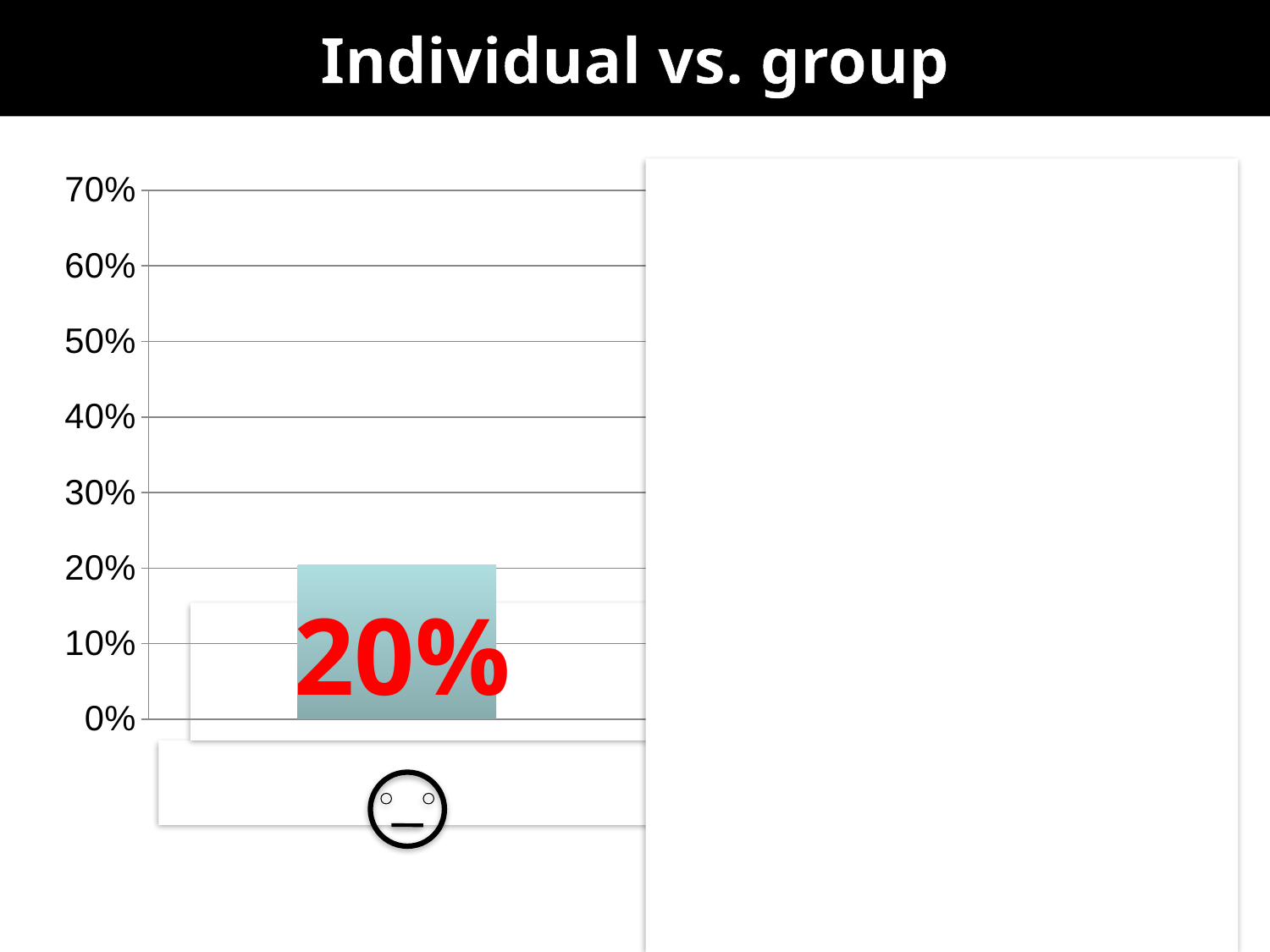
Is the value of the visible bar greater or less than 10%? greater What value is printed on the visible bar in the chart? 20% What is the highest value shown on the vertical axis of the chart? 70% What is the title of the slide containing the chart? Individual vs. group Is the value of the visible bar greater or less than 30%? less How many bars are visible in the chart? 1 What kind of chart is shown on the slide? bar chart